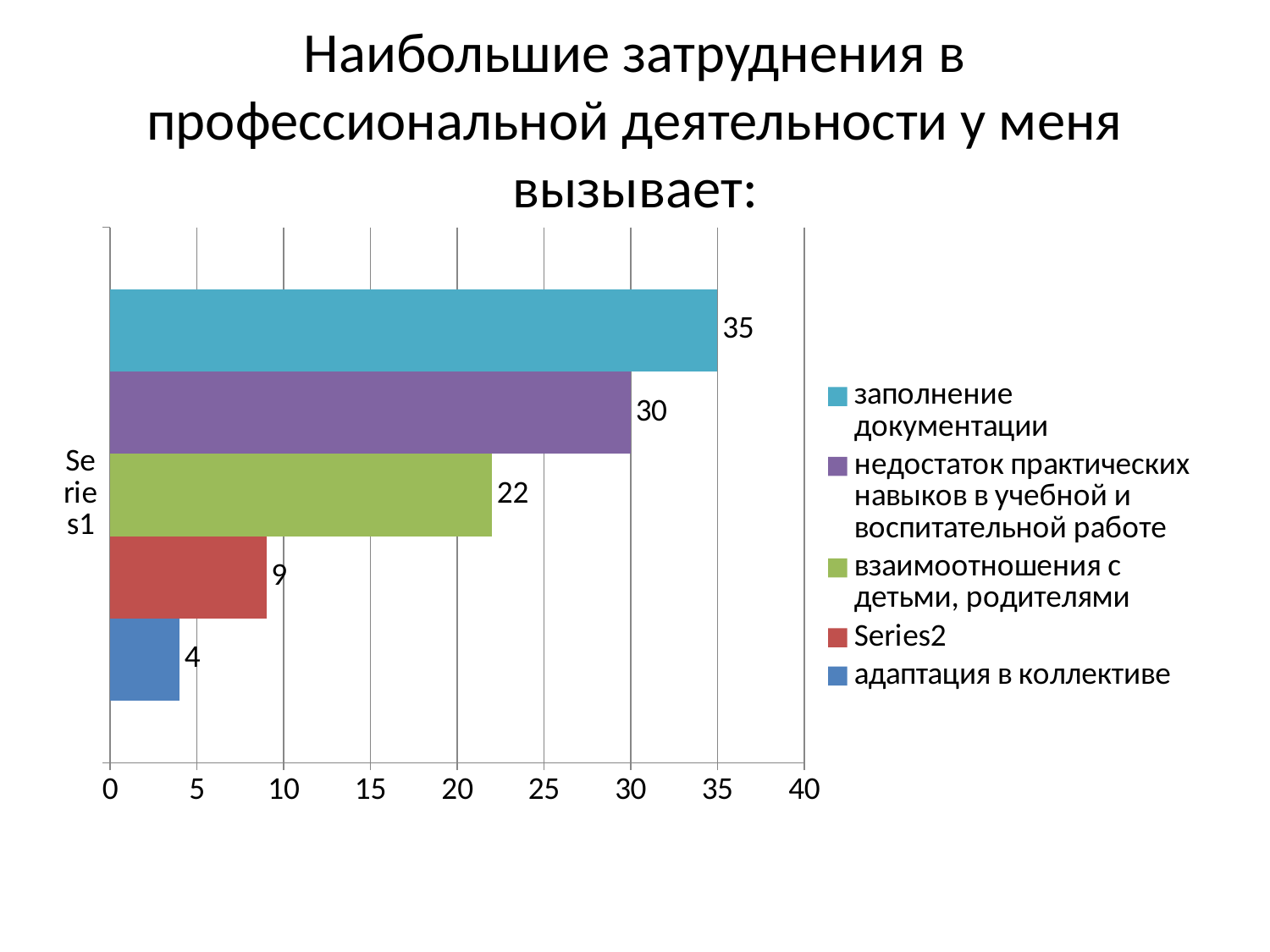
What colour is the bar for "заполнение документации"? light blue What is the value for "заполнение документации"? 35 What is the difference between the values for "заполнение документации" and "недостаток практических навыков в учебной и воспитательной работе"? 5 Which is larger: the value for "взаимоотношения с детьми, родителями" or the value for "Series2"? взаимоотношения с детьми, родителями How many series does the legend list? 5 What is the value for "взаимоотношения с детьми, родителями"? 22 Which legend entry has the lowest value? адаптация в коллективе What is the value for "недостаток практических навыков в учебной и воспитательной работе"? 30 What is the value for "адаптация в коллективе"? 4 Which legend entry has the highest value? заполнение документации What is the value for "Series2"? 9 What kind of chart is shown on the slide? bar chart